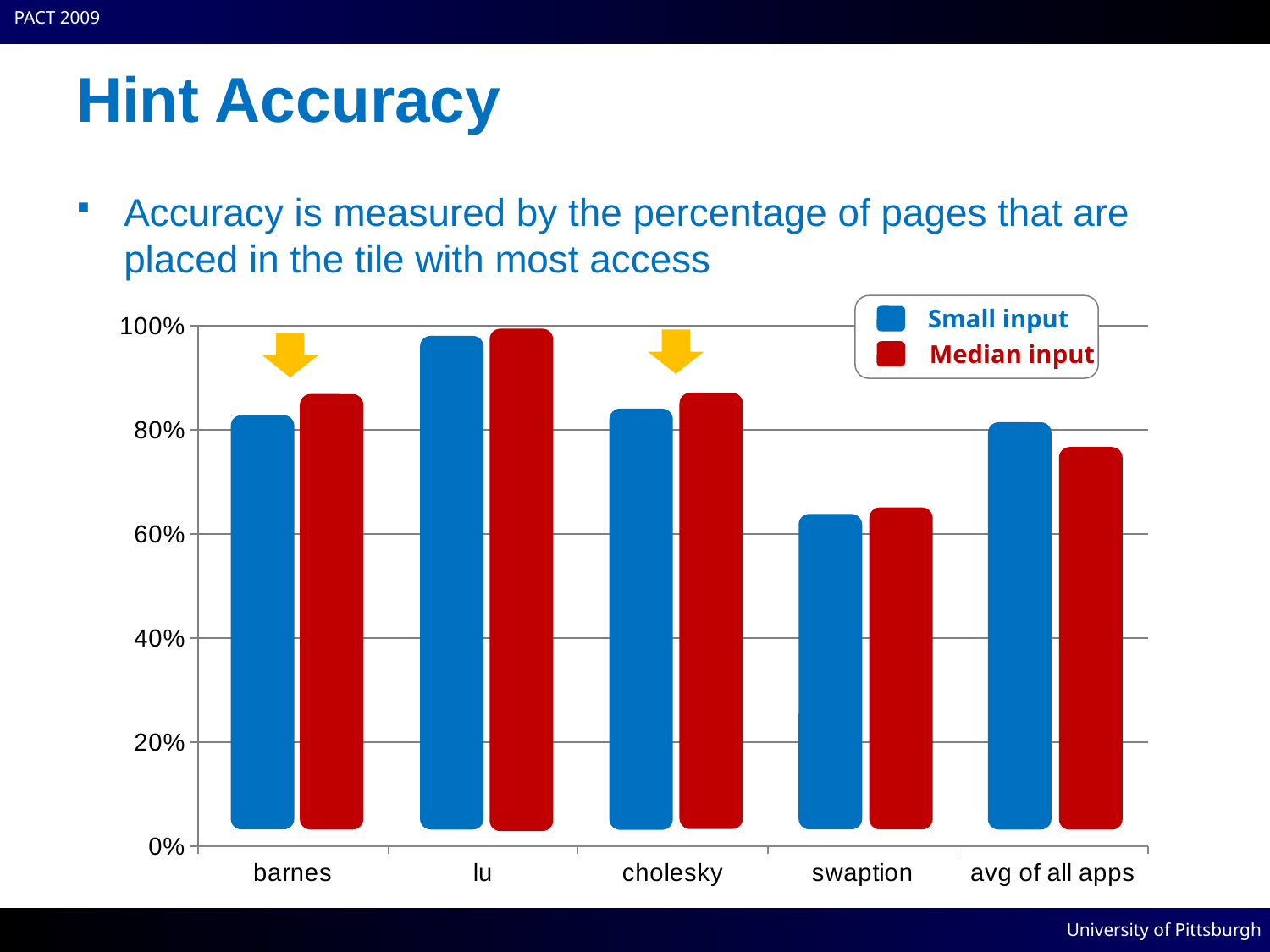
For barnes, which is larger: the Small input or the Median input accuracy? Median input Is the Small input value for swaption greater or less than 80%? less Which category has the lowest Small input accuracy? swaption How many application categories are shown on the x axis? 5 What kind of chart is shown on the slide? bar chart Is the Median input value for avg of all apps greater or less than 80%? less Is the Small input value for lu greater or less than 80%? greater How many series does the legend list? 2 Which category has the lowest Median input accuracy? swaption For avg of all apps, which is larger: the Small input or the Median input accuracy? Small input Which category has the highest Small input accuracy? lu What colour are the Median input bars? red